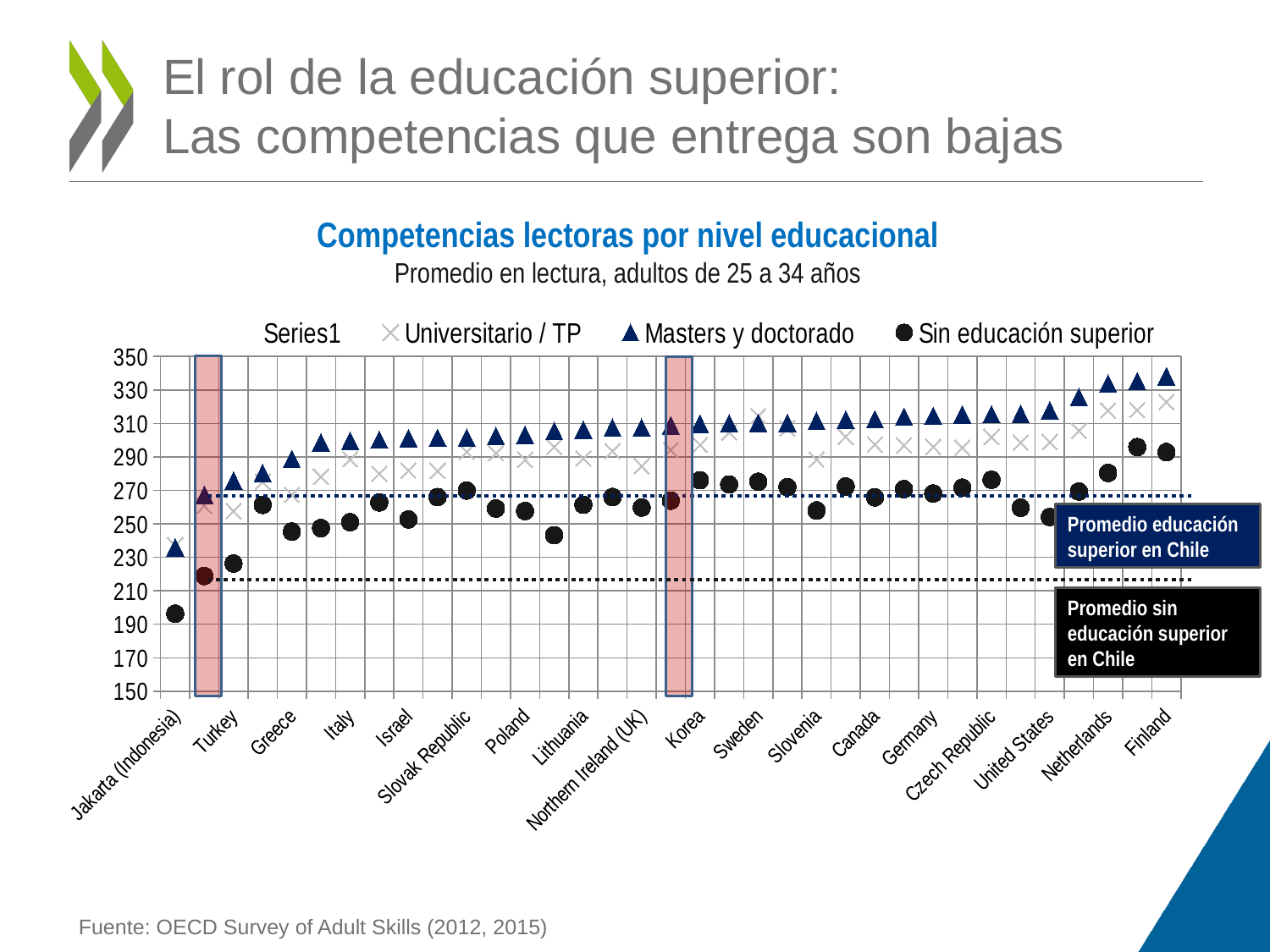
Which series in the legend is shown with a triangle marker? Masters y doctorado Is the 'Masters y doctorado' value for Jakarta (Indonesia) greater or less than 250? less What is the title of the chart? Competencias lectoras por nivel educacional Do the 'Masters y doctorado' values generally rise or fall from left to right along the x axis? rise Is the 'Sin educación superior' value for Jakarta (Indonesia) greater or less than 210? less Is the 'Masters y doctorado' value for Finland greater or less than 330? greater Which country has the lowest 'Masters y doctorado' value? Jakarta (Indonesia) Which is larger, the 'Masters y doctorado' value for Finland or for Turkey? Finland Which country has the lowest 'Sin educación superior' value? Jakarta (Indonesia) How many series does the chart legend list? 4